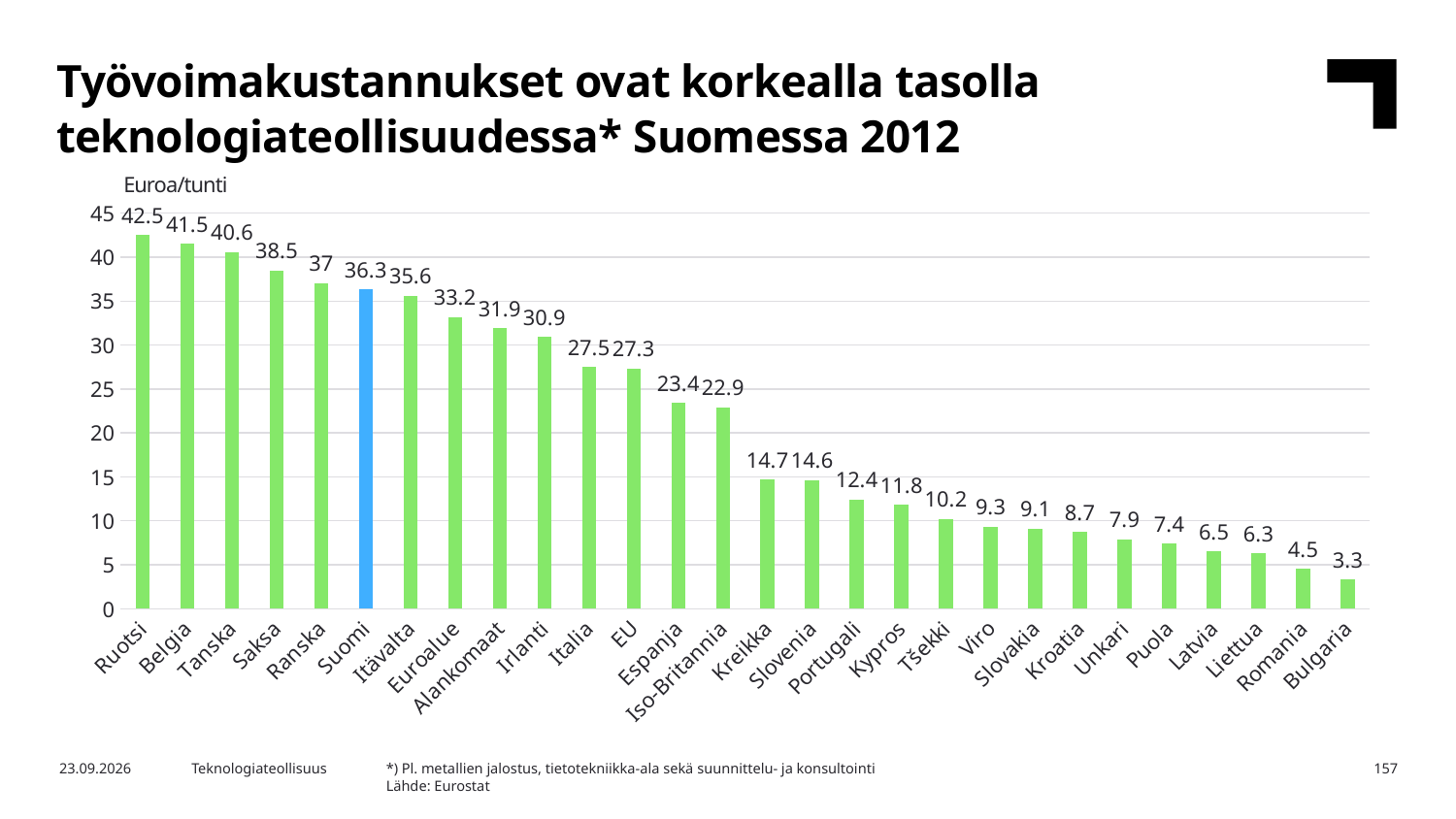
Which bar is coloured differently (blue) from the others? Suomi Which country has the highest value? Ruotsi What is the value for Suomi? 36.3 What is the value for Euroalue? 33.2 What kind of chart is shown on the slide? Bar chart Which has a larger value, Saksa or Ranska? Saksa Which country has the lowest value? Bulgaria How many countries or regions are shown on the chart? 28 What is the difference between the values for EU and Bulgaria? 24 Which has a larger value, Espanja or Kreikka? Espanja What is the value for Iso-Britannia? 22.9 What is the difference between the values for Ruotsi and Suomi? 6.2